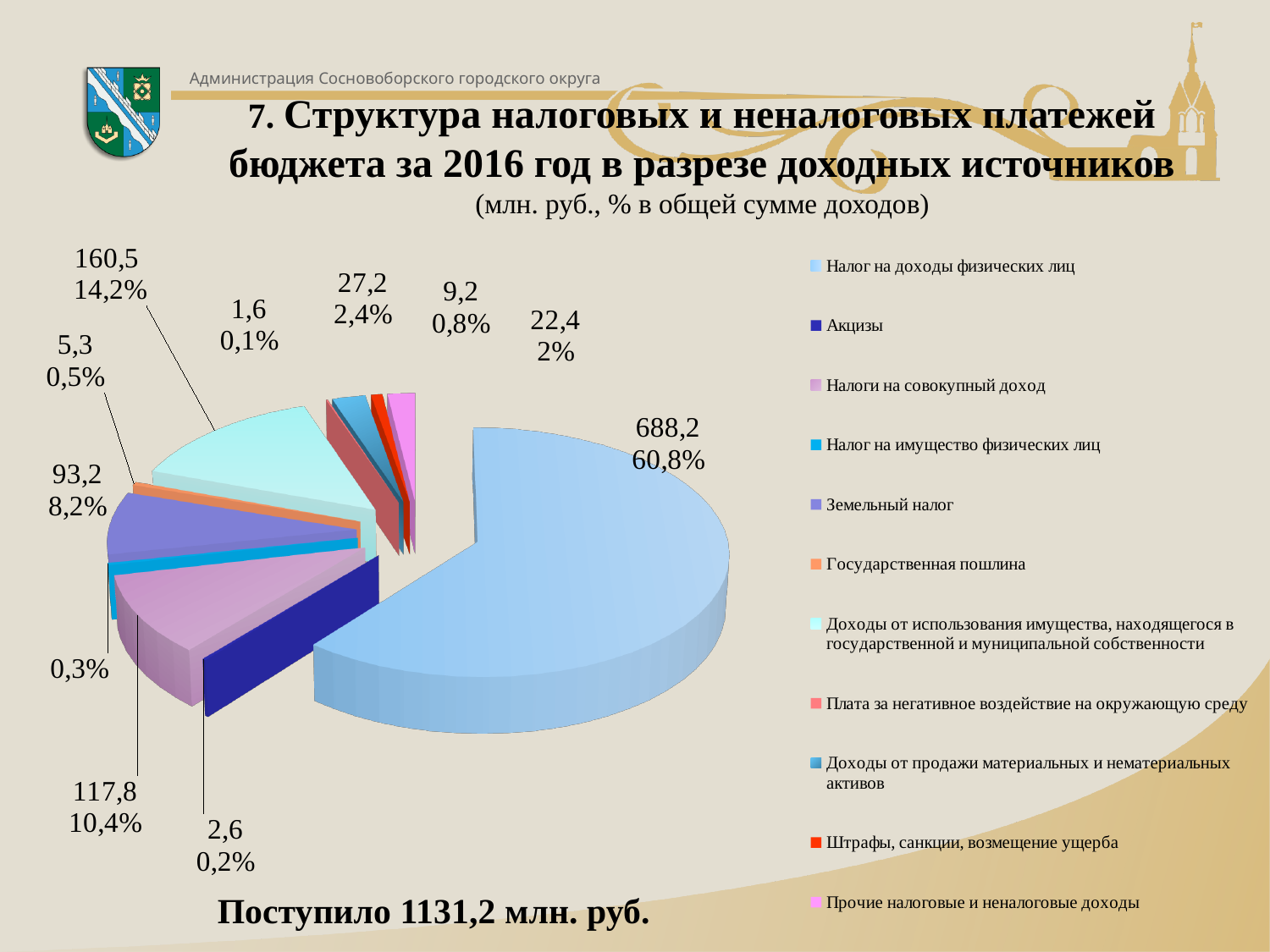
Which revenue source has the largest slice of the pie? Налог на доходы физических лиц What is the difference in млн. руб. between 'Доходы от использования имущества...' (160,5) and 'Налоги на совокупный доход' (117,8)? 42,7 What is the value (млн. руб.) for 'Доходы от использования имущества, находящегося в государственной и муниципальной собственности'? 160,5 What is the value (млн. руб.) for 'Земельный налог'? 93,2 What total amount of revenue is stated on the slide? 1131,2 млн. руб. What is the smallest percentage shown on the chart? 0,1% What kind of chart is shown on the slide? pie chart What share of total revenue does 'Налоги на совокупный доход' account for? 10,4% How many entries does the chart legend list? 11 Which is larger: 'Налоги на совокупный доход' or 'Земельный налог'? Налоги на совокупный доход What share of total revenue does 'Налог на доходы физических лиц' account for? 60,8% What is the value (млн. руб.) for 'Налог на доходы физических лиц'? 688,2